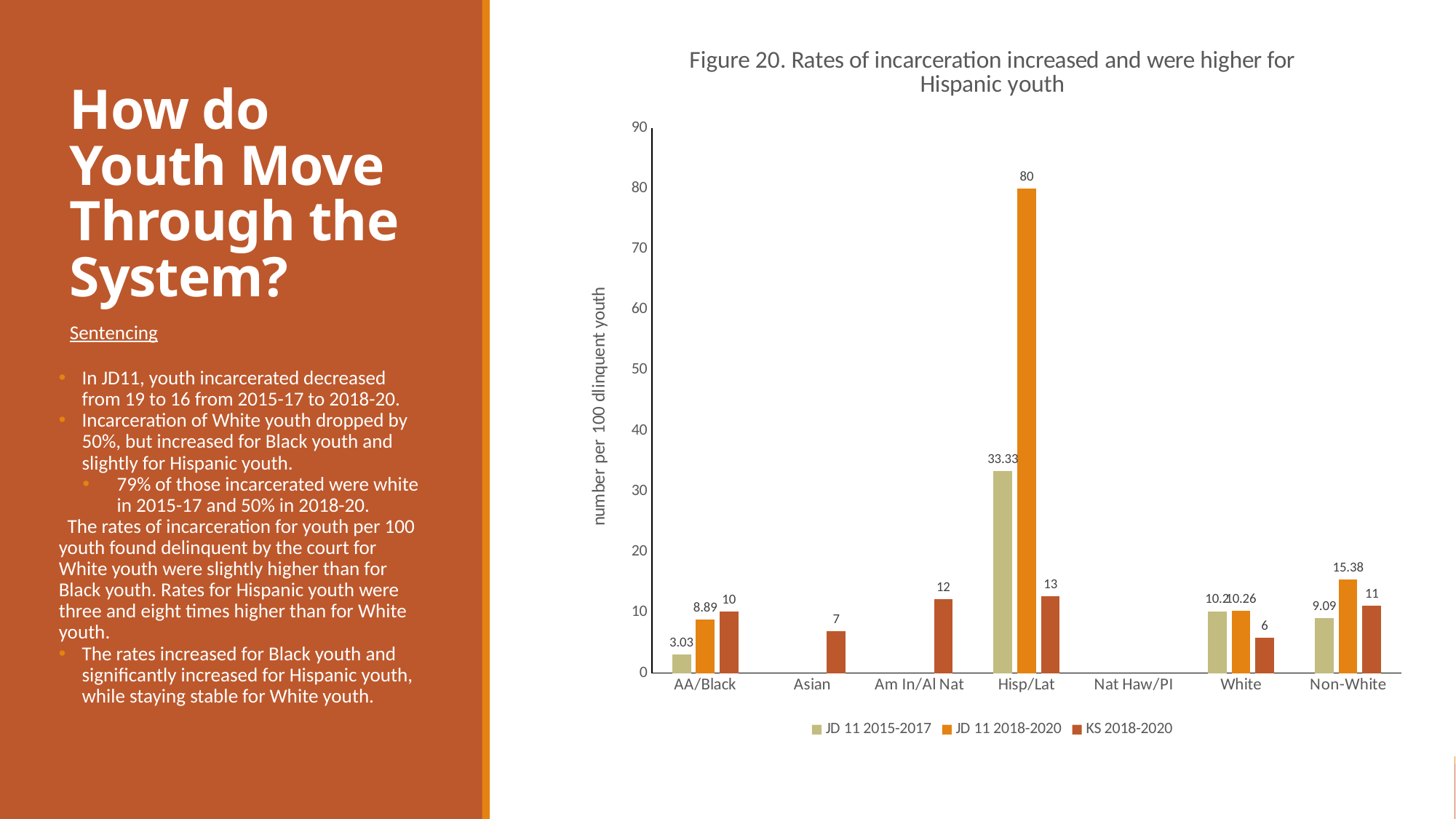
What kind of chart is shown on the slide? bar chart What is the KS 2018-2020 value for White? 6 For Hisp/Lat, what is the difference between the JD 11 2018-2020 value and the JD 11 2015-2017 value? 46.67 How many categories are shown on the x axis? 7 What is the KS 2018-2020 value for Am In/Al Nat? 12 What is the value for AA/Black in the JD 11 2015-2017 series? 3.03 Which category has the lowest value in the JD 11 2015-2017 series? AA/Black For Non-White, which series has the larger value: JD 11 2018-2020 or KS 2018-2020? JD 11 2018-2020 How many series does the legend list? 3 Is the JD 11 2015-2017 value for Hisp/Lat greater or less than 30? greater Which category has the highest value in the JD 11 2018-2020 series? Hisp/Lat What is the value for Hisp/Lat in the JD 11 2018-2020 series? 80